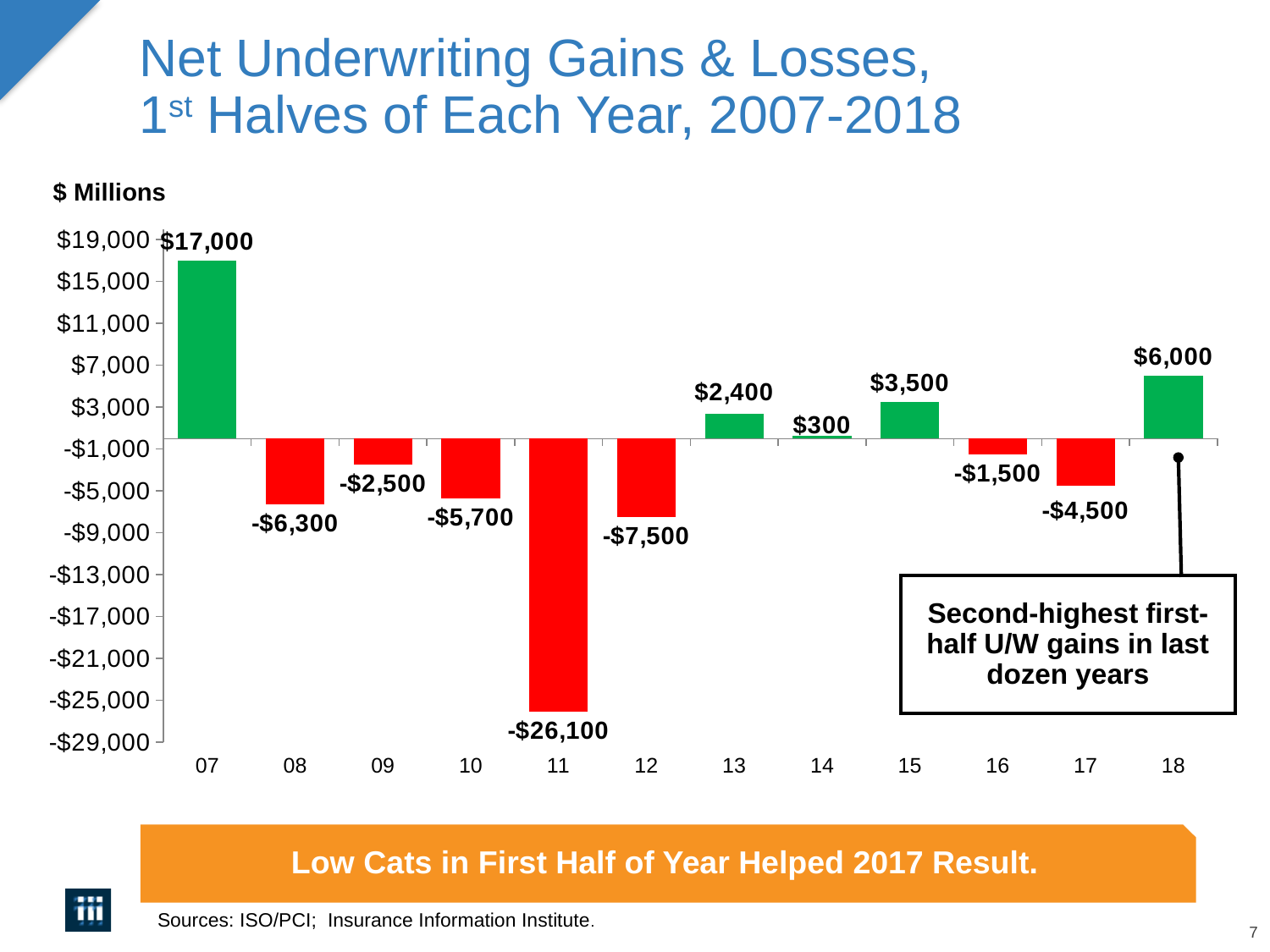
What is the net underwriting gain or loss for the first half of 2007? $17,000 What is the value shown for 2014? $300 What is the difference between the 2018 value and the 2015 value? $2,500 What colour are the bars for years with net underwriting losses? Red What is the value shown for 2018? $6,000 How many years are shown on the x axis? 12 Which year has the highest first-half net underwriting gain? 07 Which is larger, the value for 2013 or the value for 2015? 2015 What unit is stated above the chart? $ Millions What is the value shown for 2011? -$26,100 Which year has the largest first-half net underwriting loss? 11 What type of chart is shown on the slide? Bar chart